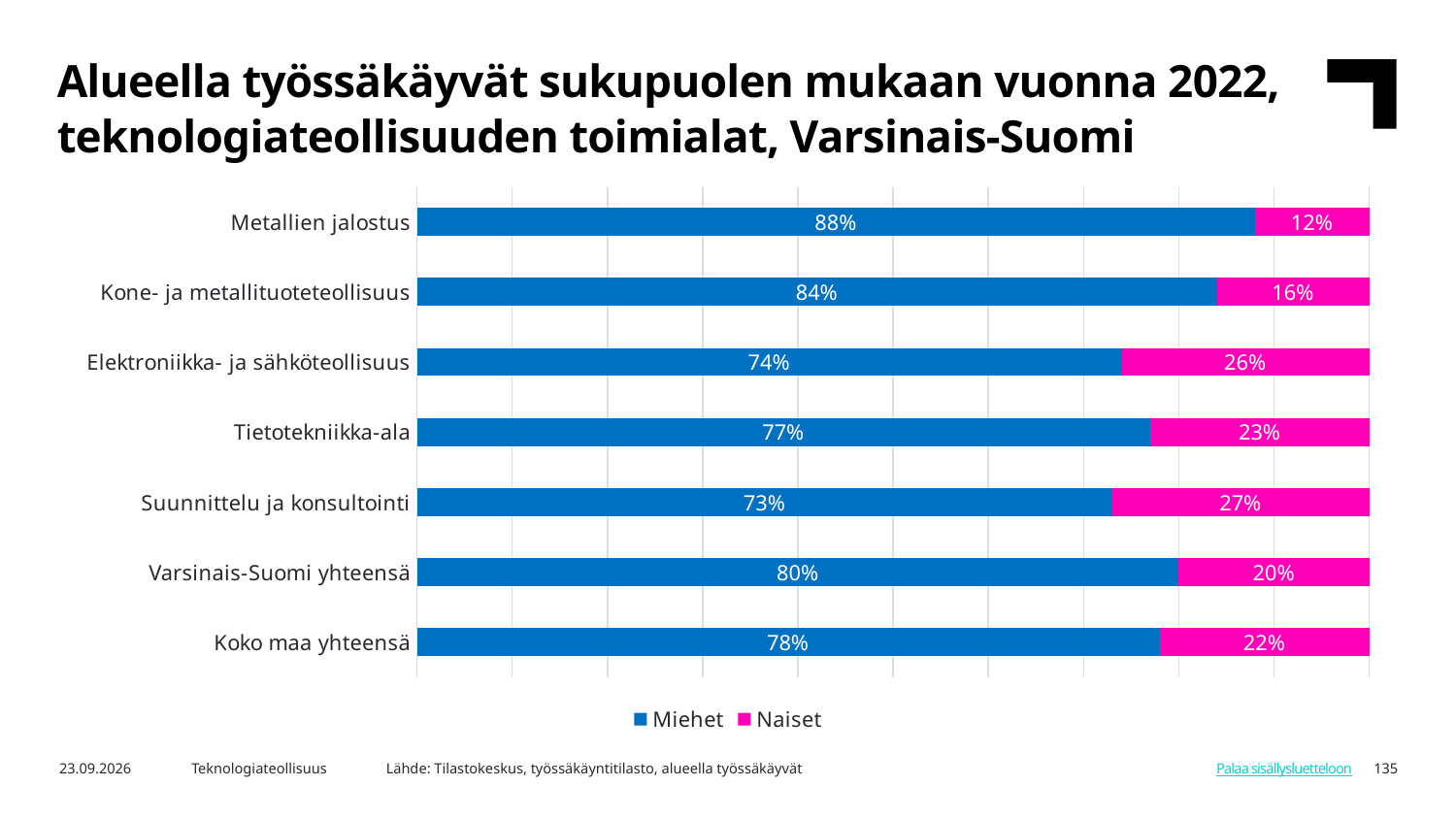
Which category has the highest Naiset share? Suunnittelu ja konsultointi What kind of chart is shown on the slide? Stacked bar chart Which category has the lowest Naiset share? Metallien jalostus What is the total of the stacked bar for Tietotekniikka-ala? 100% Which has a larger Naiset share, Elektroniikka- ja sähköteollisuus or Varsinais-Suomi yhteensä? Elektroniikka- ja sähköteollisuus How many categories are shown on the chart? 7 What is the difference between the Miehet share for Kone- ja metallituoteteollisuus and for Tietotekniikka-ala? 7% What is the Naiset share for Koko maa yhteensä? 22% Which category has the highest Miehet share? Metallien jalostus What is the Miehet share for Metallien jalostus? 88% What is the Naiset share for Suunnittelu ja konsultointi? 27% How many series does the legend list? 2